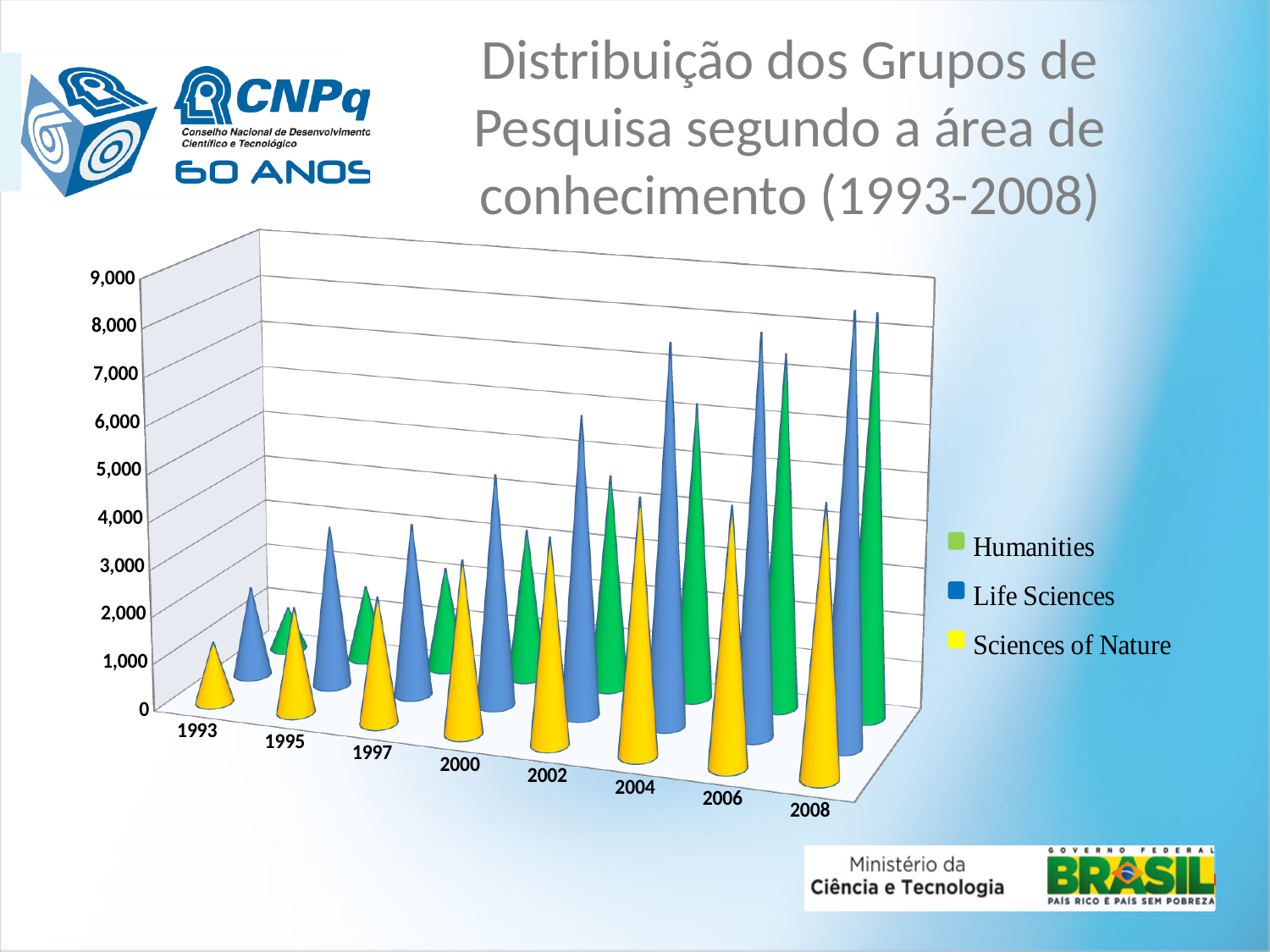
In which year is the Life Sciences value lowest? 1993 What kind of chart is shown on the slide? bar chart Which series is shown in green in the legend? Humanities How many series does the chart legend list? 3 Is the value for Life Sciences in 2008 greater or less than 5,000? greater Is the value for Sciences of Nature in 1993 greater or less than 3,000? less Which series is shown in yellow in the legend? Sciences of Nature In 2008, which is larger: Life Sciences or Sciences of Nature? Life Sciences Is the value for Sciences of Nature in 2008 greater or less than 7,000? less Does the Life Sciences series rise or fall from 1993 to 2008? rise How many years are shown on the x axis of the chart? 8